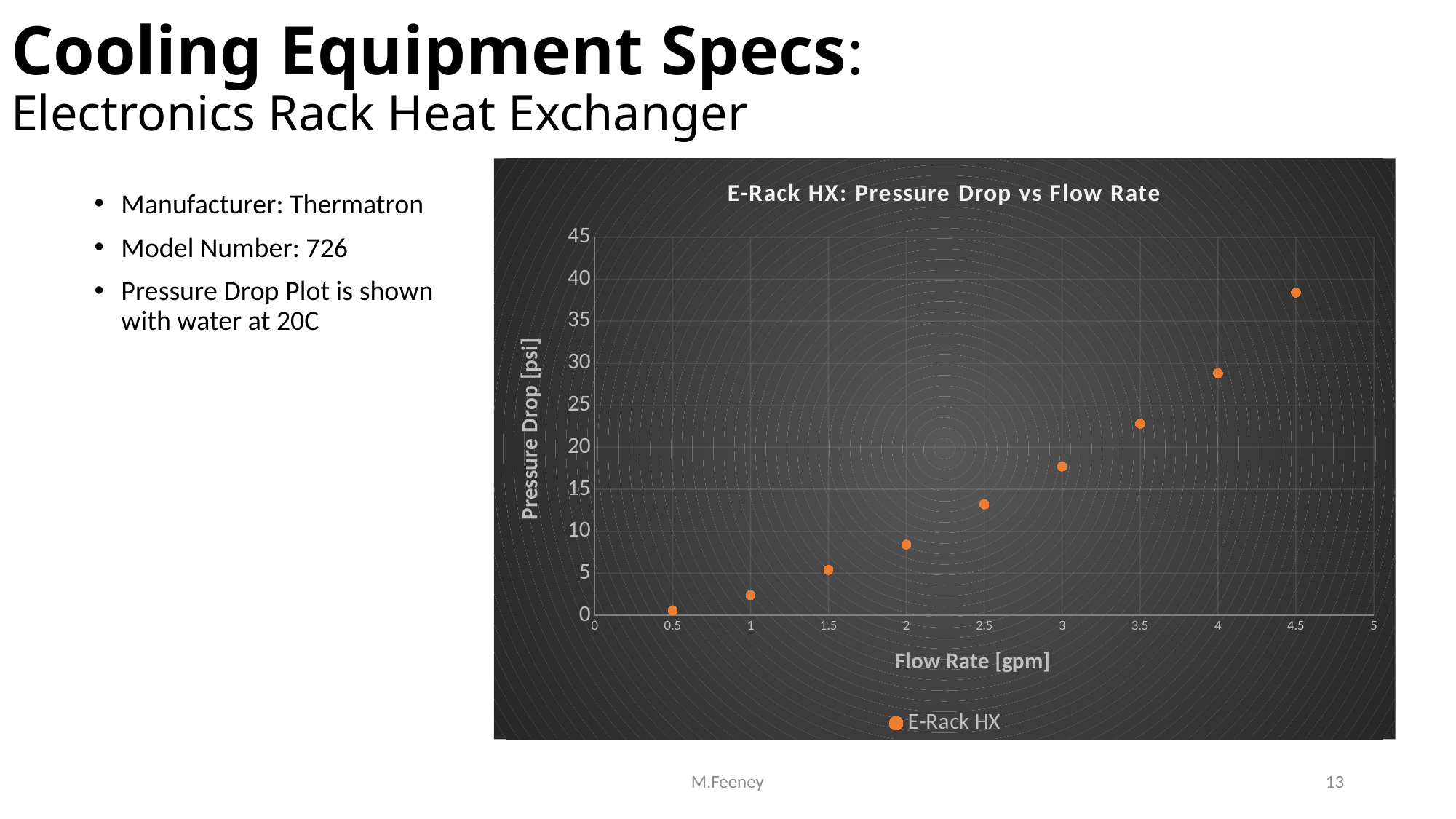
Is the pressure drop at a flow rate of 3.5 gpm greater or less than 20 psi? greater Is the pressure drop at a flow rate of 2 gpm greater or less than 10 psi? less Which has the larger pressure drop: a flow rate of 3 gpm or a flow rate of 4 gpm? 4 gpm Does the pressure drop rise or fall as flow rate increases along the x axis? rise How many series does the legend list? 1 What is the label of the y axis? Pressure Drop [psi] At which flow rate is the pressure drop lowest? 0.5 What kind of chart is shown on the slide? scatter plot What is the title of the chart? E-Rack HX: Pressure Drop vs Flow Rate At which flow rate is the pressure drop highest? 4.5 How many data points are plotted in the chart? 9 Is the pressure drop at a flow rate of 4.5 gpm greater or less than 35 psi? greater